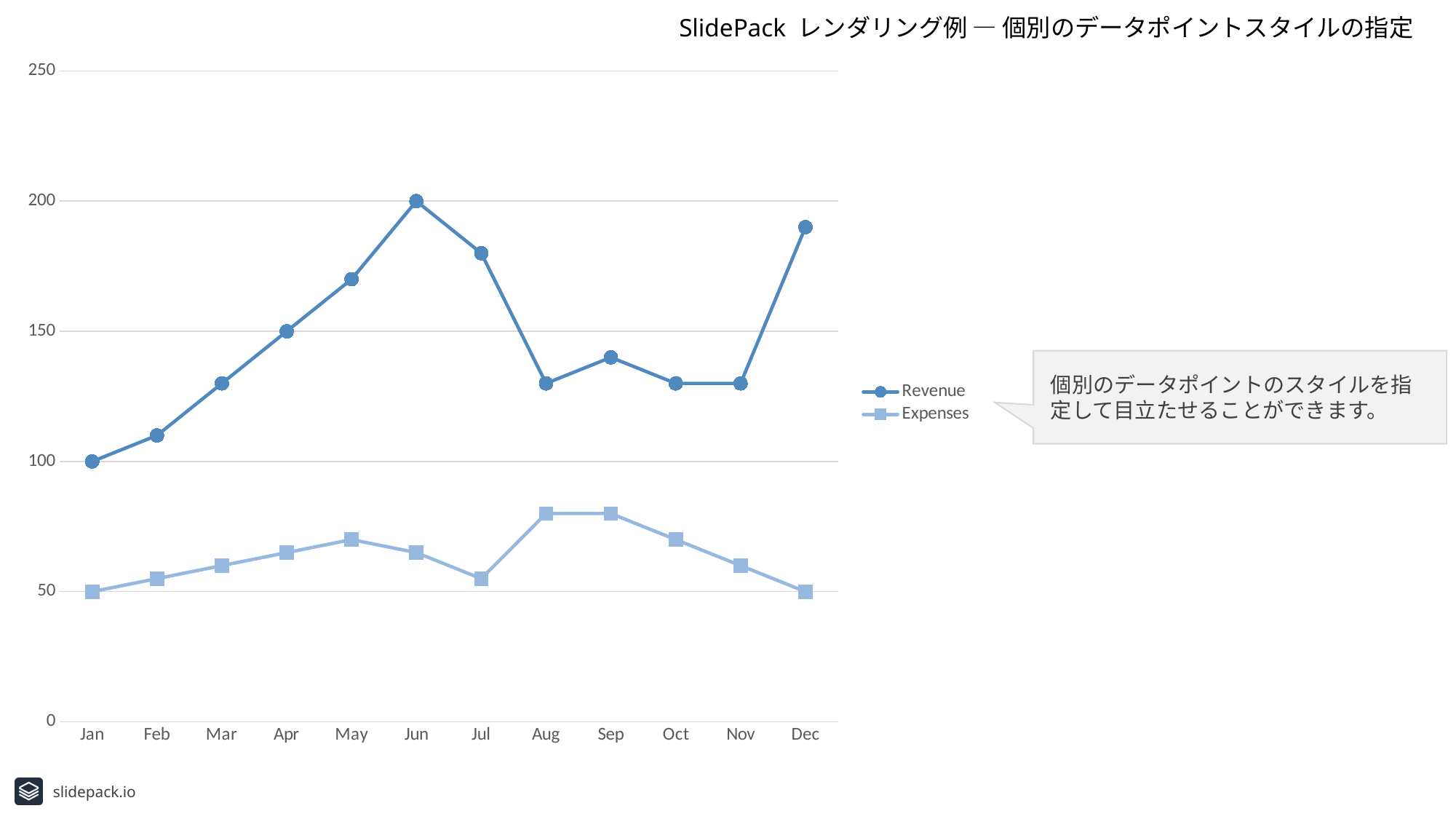
How many series does the legend list? 2 In which month is Revenue highest? Jun What type of chart is shown on the slide? line chart What is the Revenue value for Jun? 200 Does Revenue rise or fall from Jan to Jun? rise How many months are plotted along the x axis? 12 In which month is Revenue lowest? Jan What is the Expenses value for Jan? 50 Which is larger, Revenue in Jun or Revenue in Dec? Jun Is the Revenue value for Dec greater or less than 150? greater What is the difference between Revenue in Jun and Revenue in Jan? 100 What is the Revenue value for Jan? 100